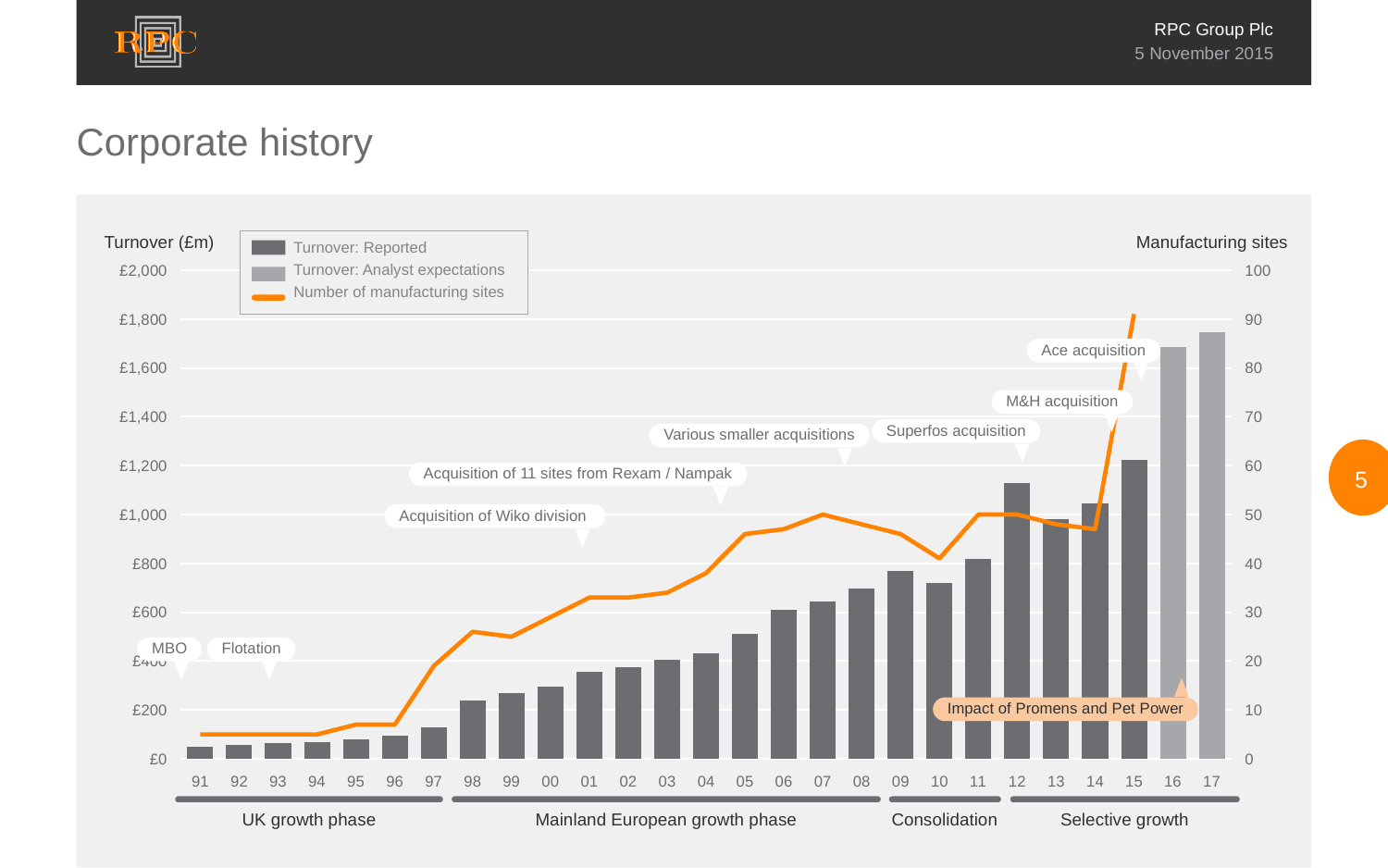
Is the reported turnover for 12 greater or less than £1,000? greater Does turnover generally rise or fall from 91 to 17? Rise What kind of chart is shown on the slide? A combined bar and line chart Is the number of manufacturing sites in 10 greater or less than 50? less Which year has the highest turnover bar? 17 Which year has the larger reported turnover, 12 or 13? 12 Is the number of manufacturing sites in 07 greater or less than 40? greater Which years are shown as analyst expectations rather than reported turnover? 16 and 17 Which year has the larger reported turnover, 09 or 10? 09 How many series does the legend list? 3 How many years are shown along the x axis? 27